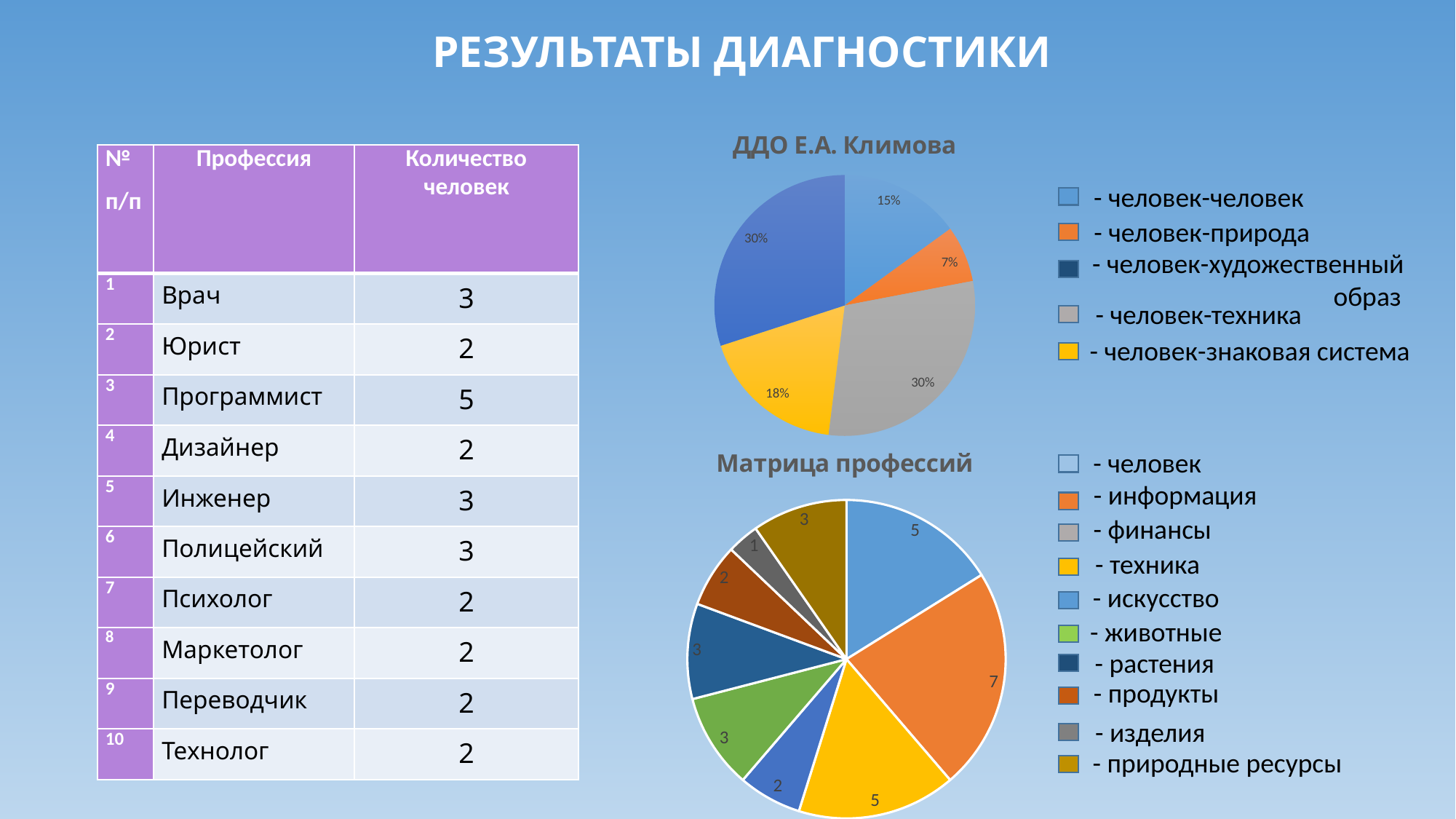
In the "ДДО Е.А. Климова" chart, what is the difference between the share for человек-техника and the share for человек-природа? 23% In the "ДДО Е.А. Климова" chart, what percentage is shown for человек-природа? 7% How many categories does the legend of the "ДДО Е.А. Климова" chart list? 5 In the "Матрица профессий" chart, what value is shown for техника? 5 In the "ДДО Е.А. Климова" chart, which is larger: человек-человек or человек-знаковая система? человек-знаковая система What kind of chart is the "ДДО Е.А. Климова" chart? pie chart In the "Матрица профессий" chart, which category has the largest value? информация In the "ДДО Е.А. Климова" chart, which category has the smallest share? человек-природа In the "Матрица профессий" chart, what value is shown for информация? 7 In the "ДДО Е.А. Климова" chart, what percentage is shown for человек-знаковая система? 18% In the "Матрица профессий" chart, what is the difference between the values for информация and техника? 2